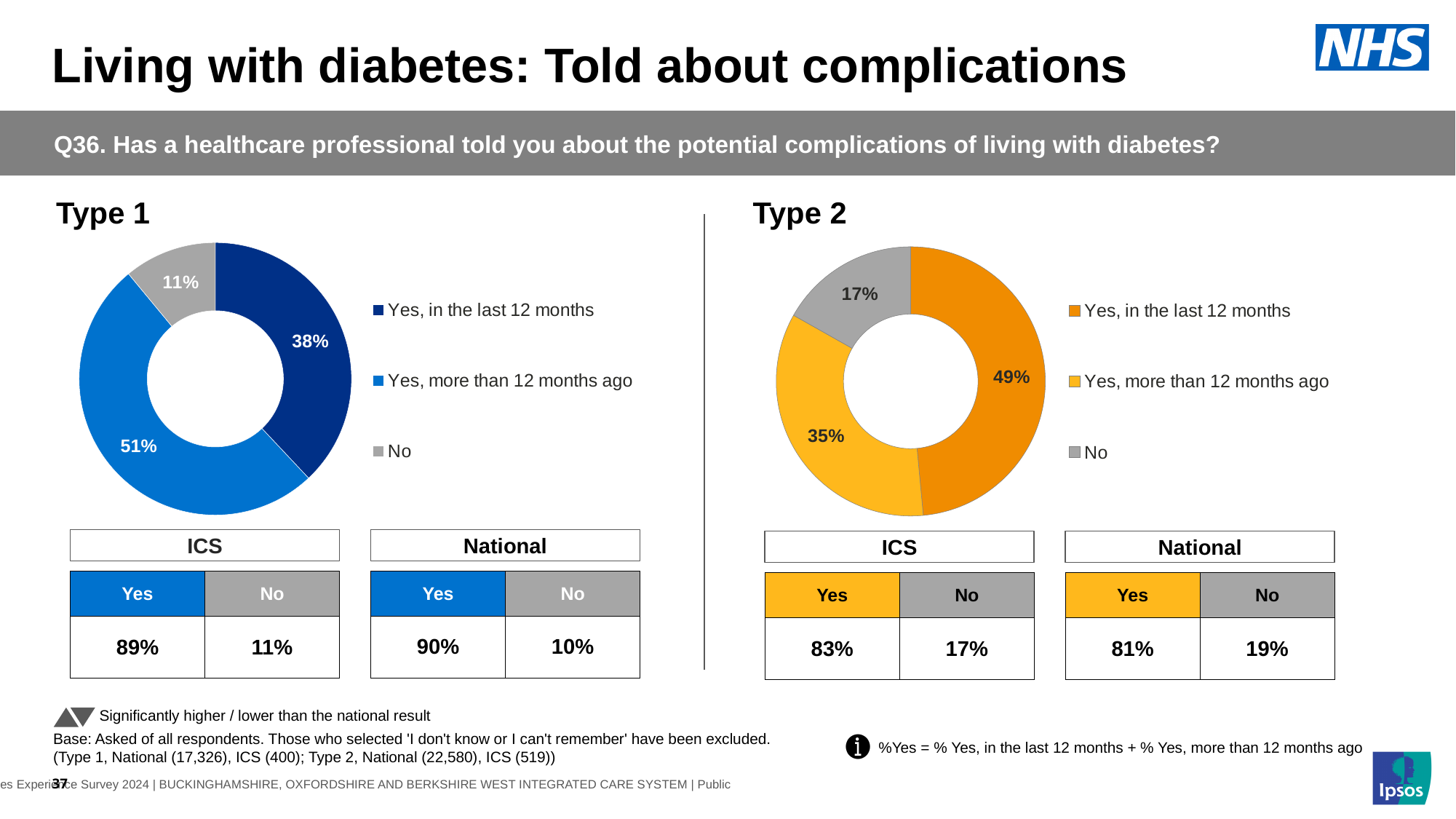
In the Type 2 chart, which category has the smallest share? No In the Type 2 chart, what is the combined share of the two 'Yes' categories? 84% In the Type 1 chart, which category has the largest share? Yes, more than 12 months ago How many categories does the Type 2 chart show? 3 In the Type 1 chart, what colour is the 'No' segment? Grey In the Type 1 chart, which is larger: 'Yes, in the last 12 months' or 'No'? Yes, in the last 12 months What type of chart is used for Type 1? Doughnut chart In the Type 1 chart, what percentage of respondents said 'Yes, in the last 12 months'? 38% In the Type 2 chart, what is the difference between the 'Yes, in the last 12 months' share and the 'Yes, more than 12 months ago' share? 14 percentage points In the Type 2 chart, what percentage of respondents said 'No'? 17% In the Type 1 chart, what percentage of respondents said 'Yes, more than 12 months ago'? 51% In the Type 2 chart, what percentage of respondents said 'Yes, in the last 12 months'? 49%